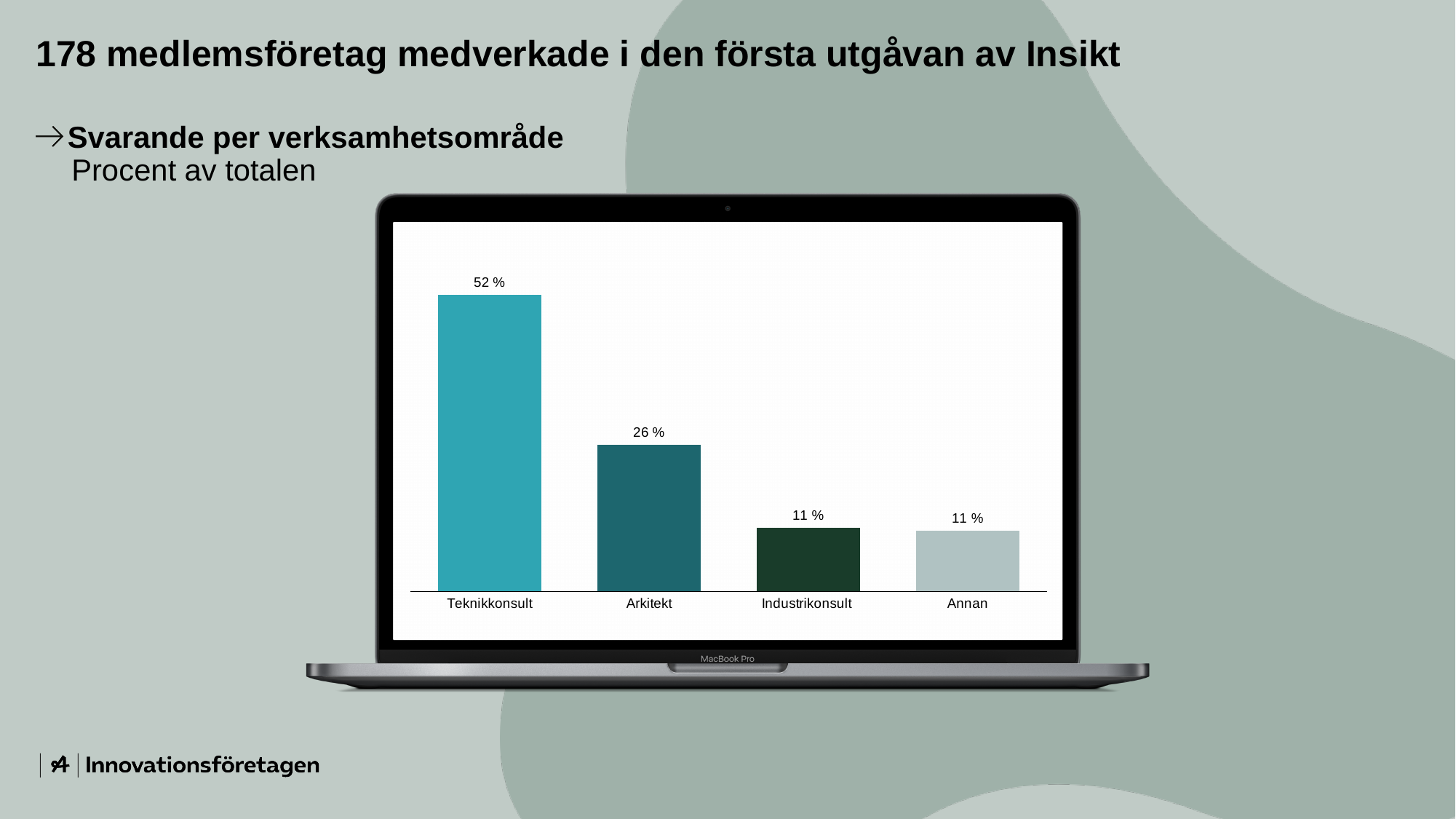
What is the difference between the values for Arkitekt and Industrikonsult? 15 % What kind of chart is shown on the slide? Bar chart How many categories are shown in the chart? 4 What is the value for Annan? 11 % What is the difference between the values for Teknikkonsult and Arkitekt? 26 % What is the value for Arkitekt? 26 % What is the value for Industrikonsult? 11 % What is the value for Teknikkonsult? 52 % Which category has the highest value? Teknikkonsult Do the values rise or fall from left to right across the categories? Fall Which is larger, the value for Arkitekt or the value for Annan? Arkitekt